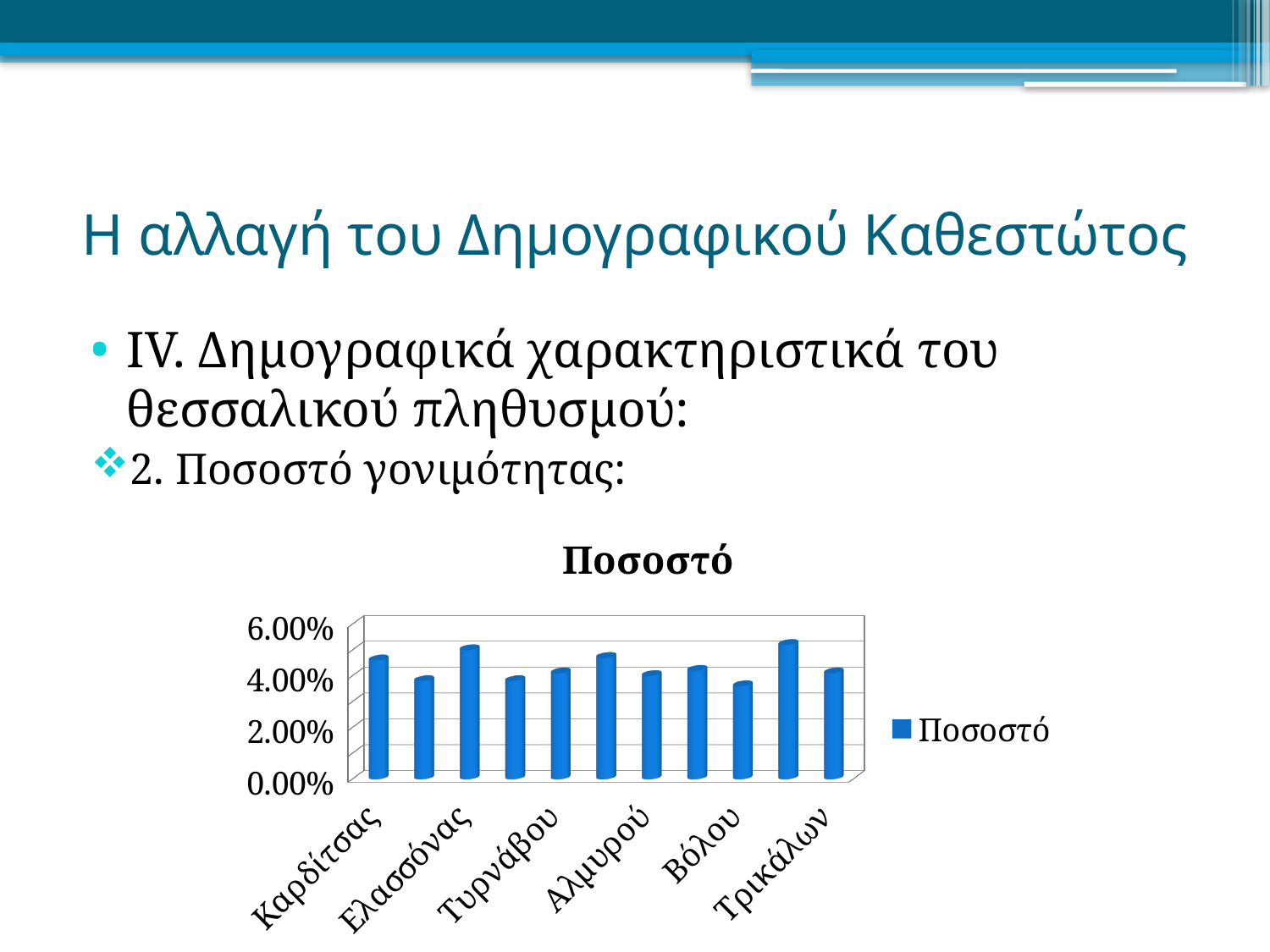
How many bars are plotted in the chart? 11 Is the value for Καρδίτσας greater or less than 4.00%? greater How many series does the legend list? 1 What is the highest value shown on the vertical axis? 6.00% Is the value for Ελασσόνας greater or less than 4.00%? greater What kind of chart is shown on the slide? bar chart What is the title of the chart? Ποσοστό Which is larger, the value for Καρδίτσας or the value for Βόλου? Καρδίτσας Which is larger, the value for Ελασσόνας or the value for Τυρνάβου? Ελασσόνας Is the value for Ελασσόνας greater or less than 6.00%? less